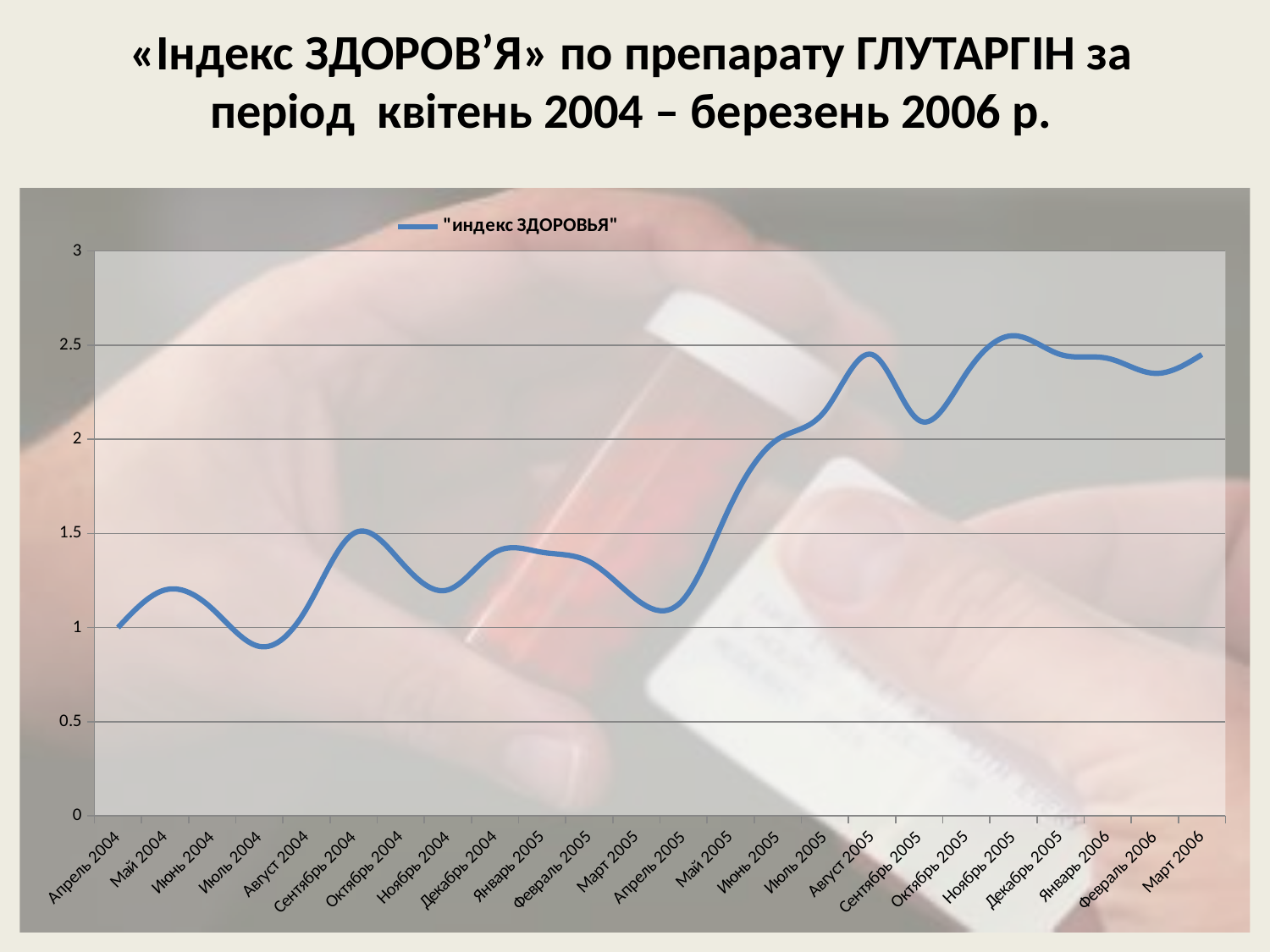
What is the value of the index for Апрель 2004? 1 Is the value for Июль 2005 greater or less than 2? greater Which month has the lowest value of the index? Июль 2004 How many series does the legend list? 1 Overall, does the index rise or fall from Апрель 2004 to Март 2006? rise How many months (points) are plotted along the x axis? 24 Which month has the highest value of the index? Ноябрь 2005 What kind of chart is shown on the slide? line chart Is the value for Июль 2004 greater or less than 1? less What is the name of the series shown in the legend? "индекс ЗДОРОВЬЯ" Which is larger, the value for Апрель 2004 or the value for Март 2006? Март 2006 Is the value for Ноябрь 2005 greater or less than 2.5? greater